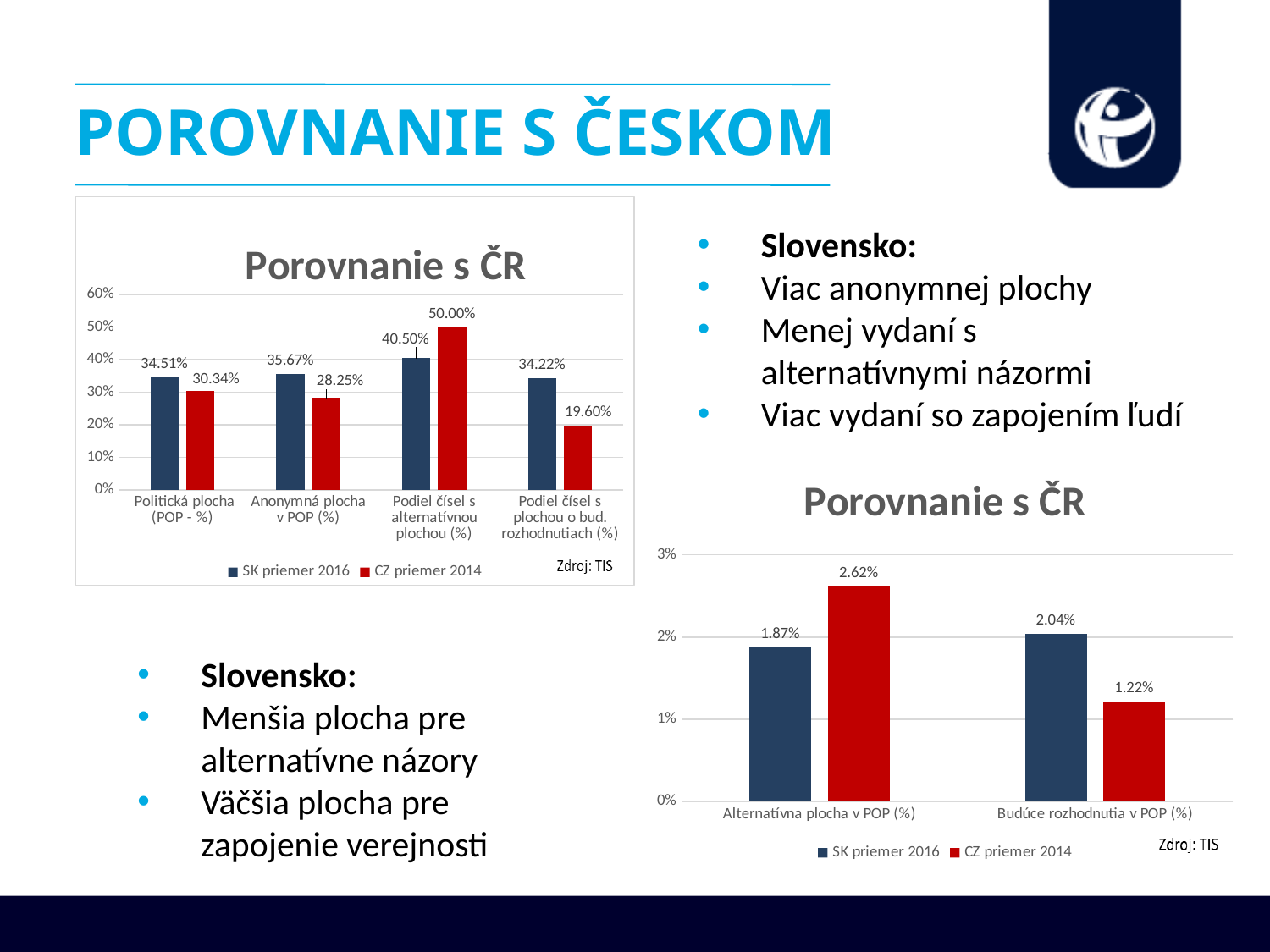
In the bottom-right chart, what is the SK priemer 2016 value for Budúce rozhodnutia v POP (%)? 2.04% How many series does the legend of the top-left chart list? 2 In the top-left chart, which is larger for Podiel čísel s alternatívnou plochou (%): SK priemer 2016 or CZ priemer 2014? CZ priemer 2014 What is the source cited below both charts? TIS In the top-left chart, what is the CZ priemer 2014 value for Podiel čísel s plochou o bud. rozhodnutiach (%)? 19.60% In the bottom-right chart, what is the difference between the SK priemer 2016 and CZ priemer 2014 values for Budúce rozhodnutia v POP (%)? 0.82% In the top-left chart, what is the difference between the SK priemer 2016 and CZ priemer 2014 values for Politická plocha (POP - %)? 4.17% In the top-left chart, what is the SK priemer 2016 value for Anonymná plocha v POP (%)? 35.67% How many categories are shown on the x axis of the top-left chart? 4 What kind of chart is the bottom-right chart? Bar chart In the top-left chart, which category has the highest CZ priemer 2014 value? Podiel čísel s alternatívnou plochou (%) In the bottom-right chart, what is the CZ priemer 2014 value for Alternatívna plocha v POP (%)? 2.62%